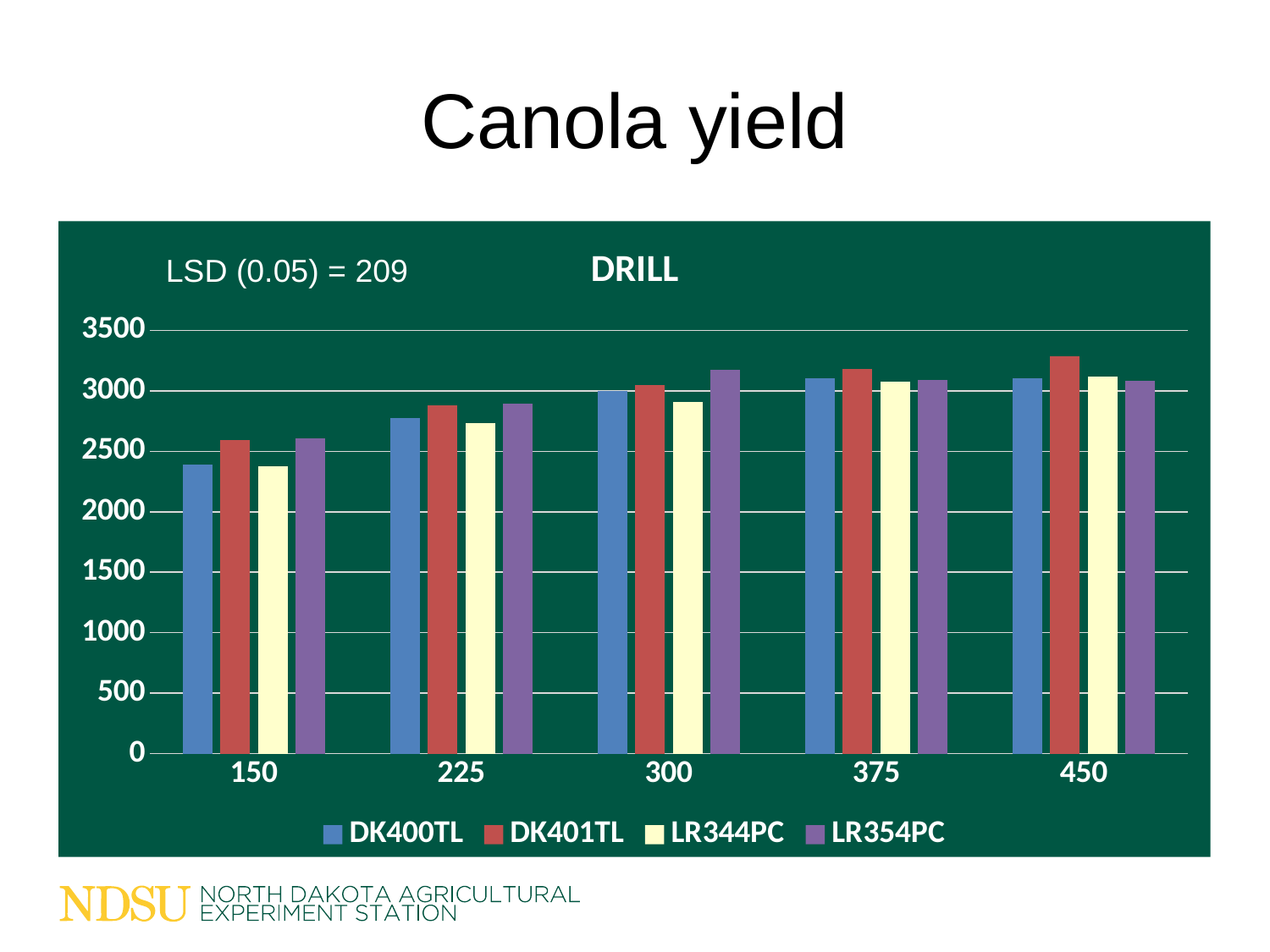
How many categories are shown on the x axis? 5 Is the value for LR344PC at 300 greater or less than 3000? less Is the value for DK400TL at 150 greater or less than 2500? less Is the value for LR354PC at 300 greater or less than 3000? greater What kind of chart is shown on the slide? bar chart How many series does the legend list? 4 What LSD value is printed on the chart? LSD (0.05) = 209 Do the DK401TL values generally rise or fall as the x axis goes from 150 to 450? rise Which series has the highest bar at 450? DK401TL At 150, which is larger, DK401TL or LR344PC? DK401TL What is the title printed above the plot area of the chart? DRILL